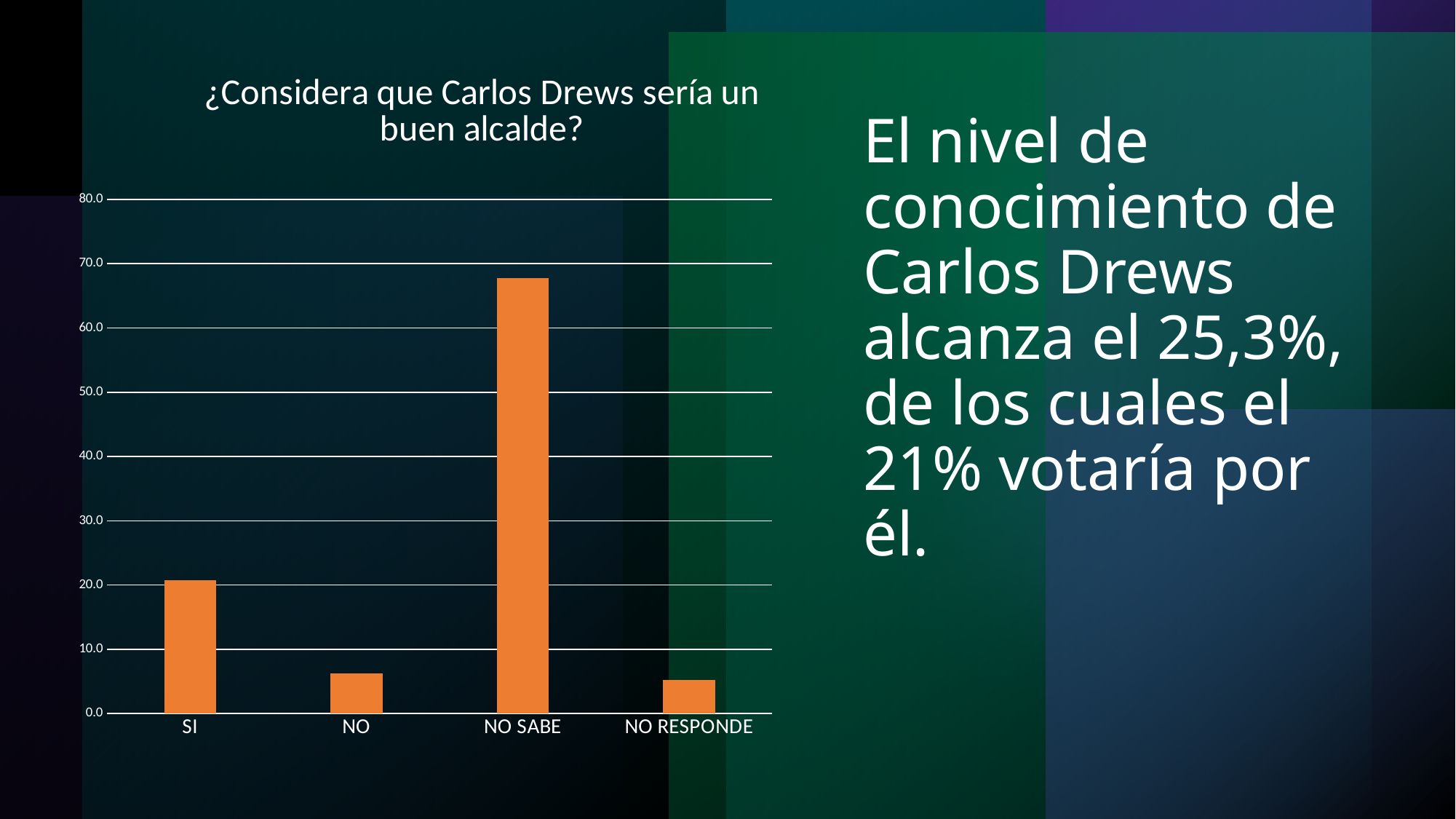
Which is larger, the value for NO SABE or the value for SI? NO SABE What is the title of the chart? ¿Considera que Carlos Drews sería un buen alcalde? Is the value for NO RESPONDE greater or less than 10? less Is the value for NO SABE greater or less than 60? greater Is the value for NO SABE greater or less than 70? less Which is larger, the value for SI or the value for NO? SI How many categories are shown on the x axis of the chart? 4 What is the highest value shown on the chart's vertical axis? 80.0 What kind of chart is shown on the slide? bar chart Which category has the highest bar in the chart? NO SABE